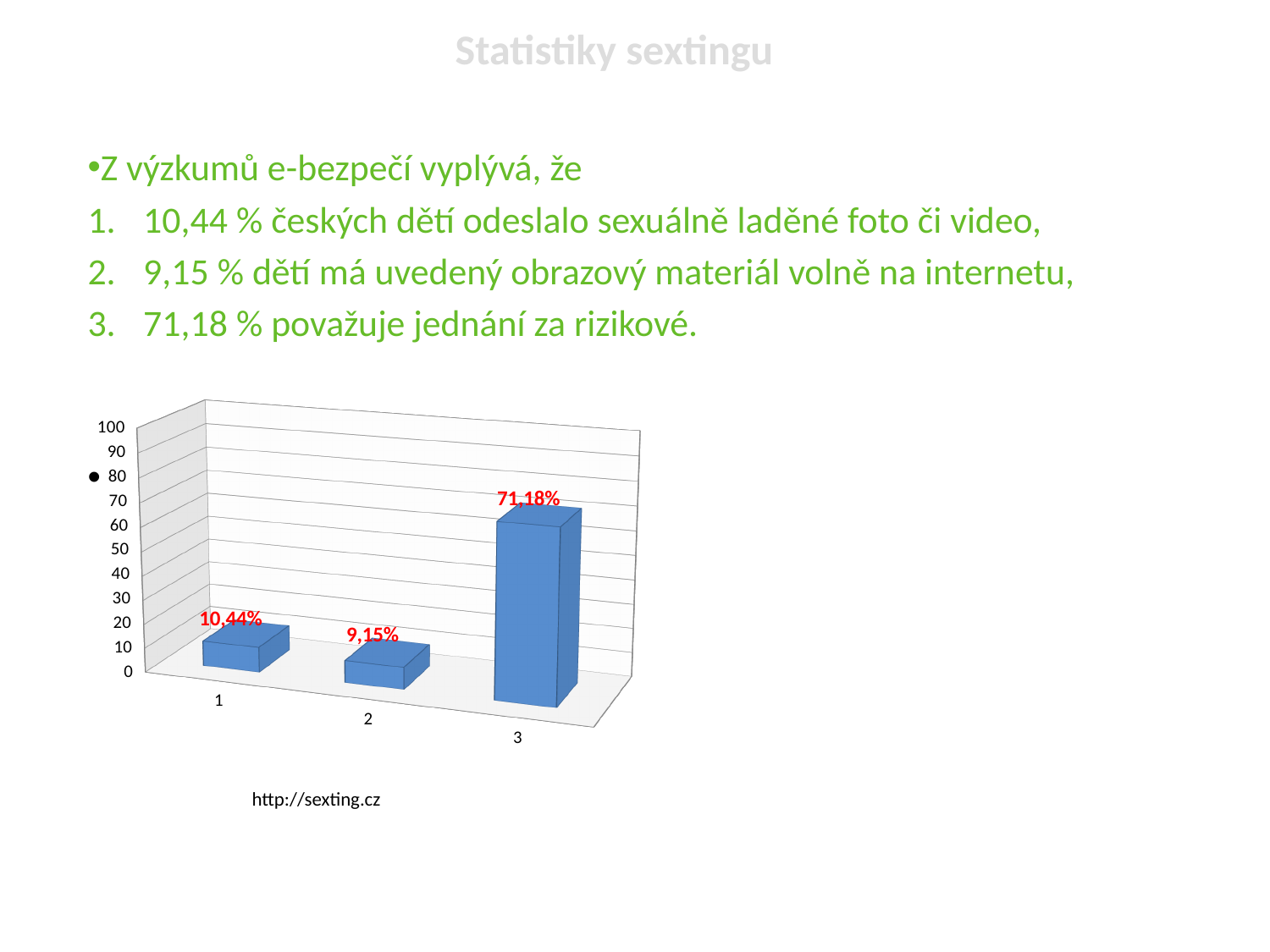
What is the value for category 2? 9,15% What is the value for category 3? 71,18% What is the difference between the values for category 3 and category 1? 60,74% What is the difference between the values for category 1 and category 2? 1,29% What is the value for category 1? 10,44% Which is larger, the value for category 1 or category 2? category 1 Is the value for category 3 greater or less than 50? greater What is the highest value shown on the vertical axis of the chart? 100 What kind of chart is shown on the slide? bar chart Which category has the lowest value? 2 Which category has the highest value? 3 How many categories are shown on the chart? 3